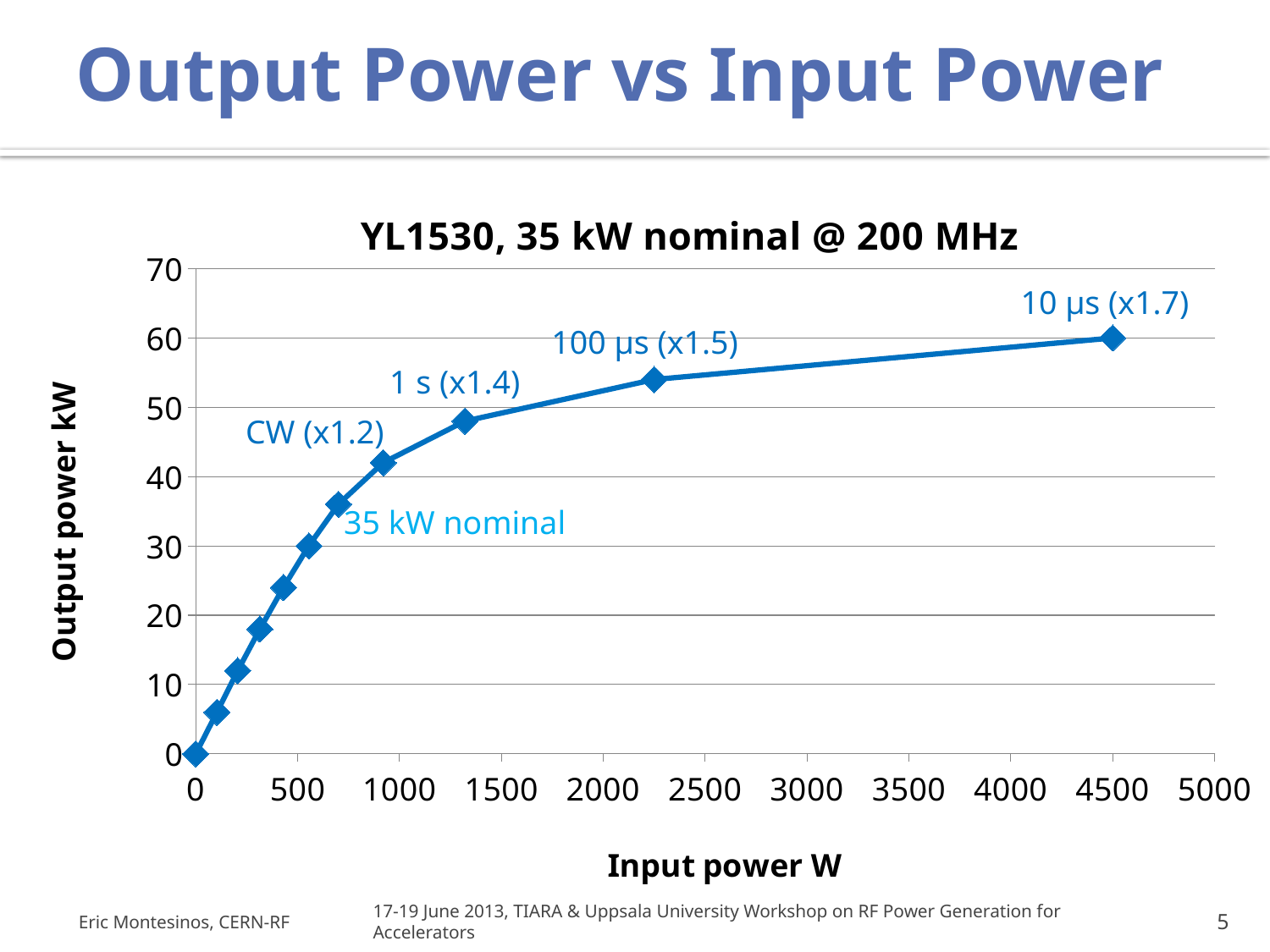
Does the output power rise or fall as input power increases along the x axis? rise Is the output power at the point labelled "1 s (x1.4)" greater or less than 50? less Which point has the higher output power, "1 s (x1.4)" or "CW (x1.2)"? 1 s (x1.4) What is the output power in kW at the point labelled "10 µs (x1.7)"? 60 What kind of chart is shown on the slide? line chart What is the title of the chart? YL1530, 35 kW nominal @ 200 MHz What is the label of the x axis? Input power W Is the output power at the point labelled "100 µs (x1.5)" greater or less than 50? greater Is the input power at the point labelled "CW (x1.2)" greater or less than 1000? less Which labelled point has the highest output power? 10 µs (x1.7) How many data points are plotted on the line? 11 What is the input power in W at the point labelled "10 µs (x1.7)"? 4500